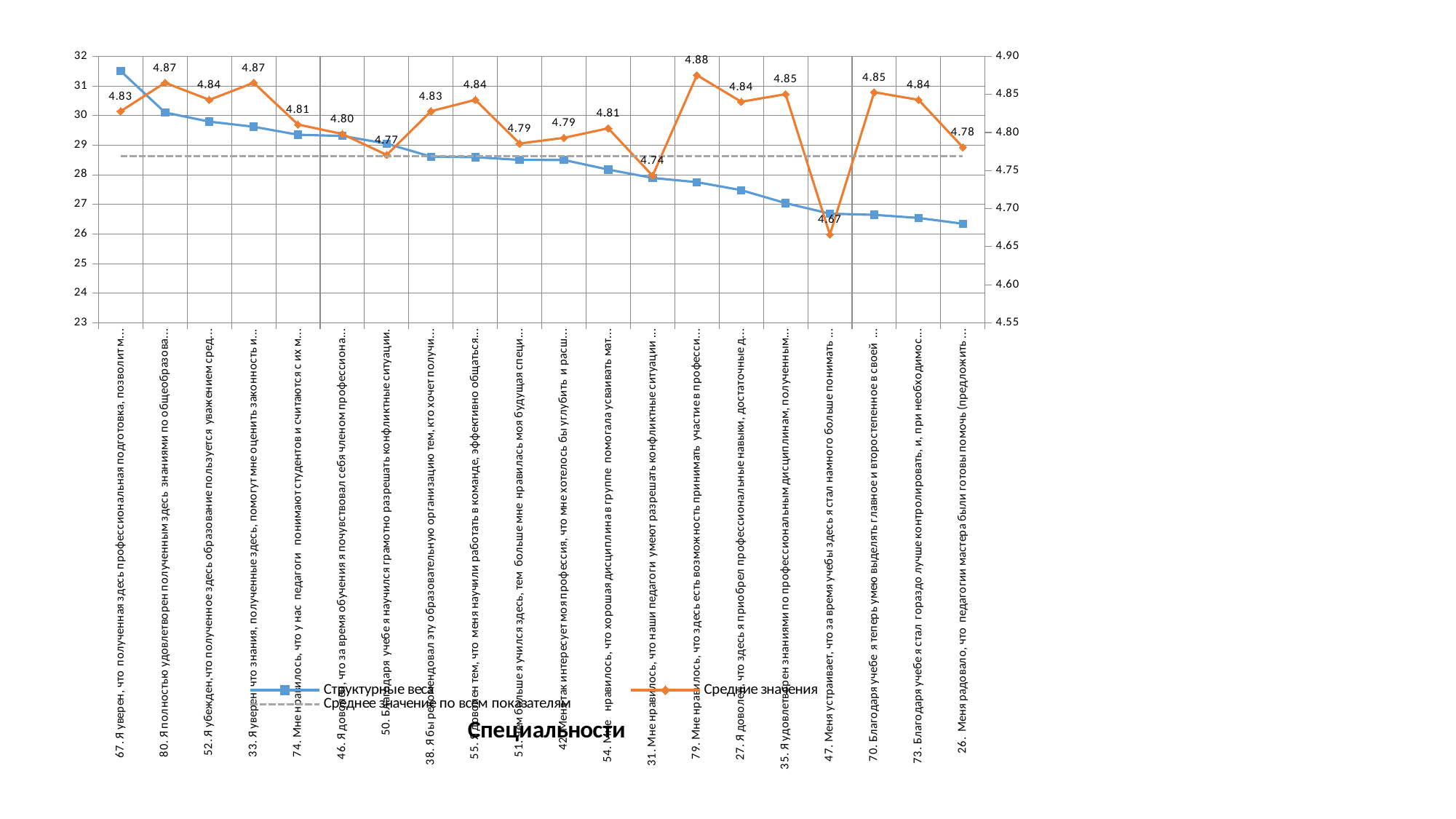
Is the "Структурные веса" value for item 26 (the last category) greater or less than 27? less How many series does the legend list? 3 Do the "Структурные веса" values rise or fall from left to right along the x axis? fall What is the difference between the highest and lowest values of "Средние значения"? 0.21 Which has a larger "Средние значения" value: item 80 or item 31? item 80 Which category has the highest value of "Средние значения"? 79. Мне нравилось, что здесь есть возможность принимать участие в професси... (4.88) Is the "Структурные веса" value for item 67 (the first category) greater or less than 31? greater What is the value of "Средние значения" for item 47 ("Меня устраивает, что за время учебы здесь я стал намного больше понимать...")? 4.67 Which category has the lowest value of "Средние значения"? 47. Меня устраивает, что за время учебы здесь я стал намного больше понимать... (4.67) How many categories are plotted along the x axis? 20 What kind of chart is shown on the slide? line chart What is the value of "Средние значения" for item 67 (the first category)? 4.83